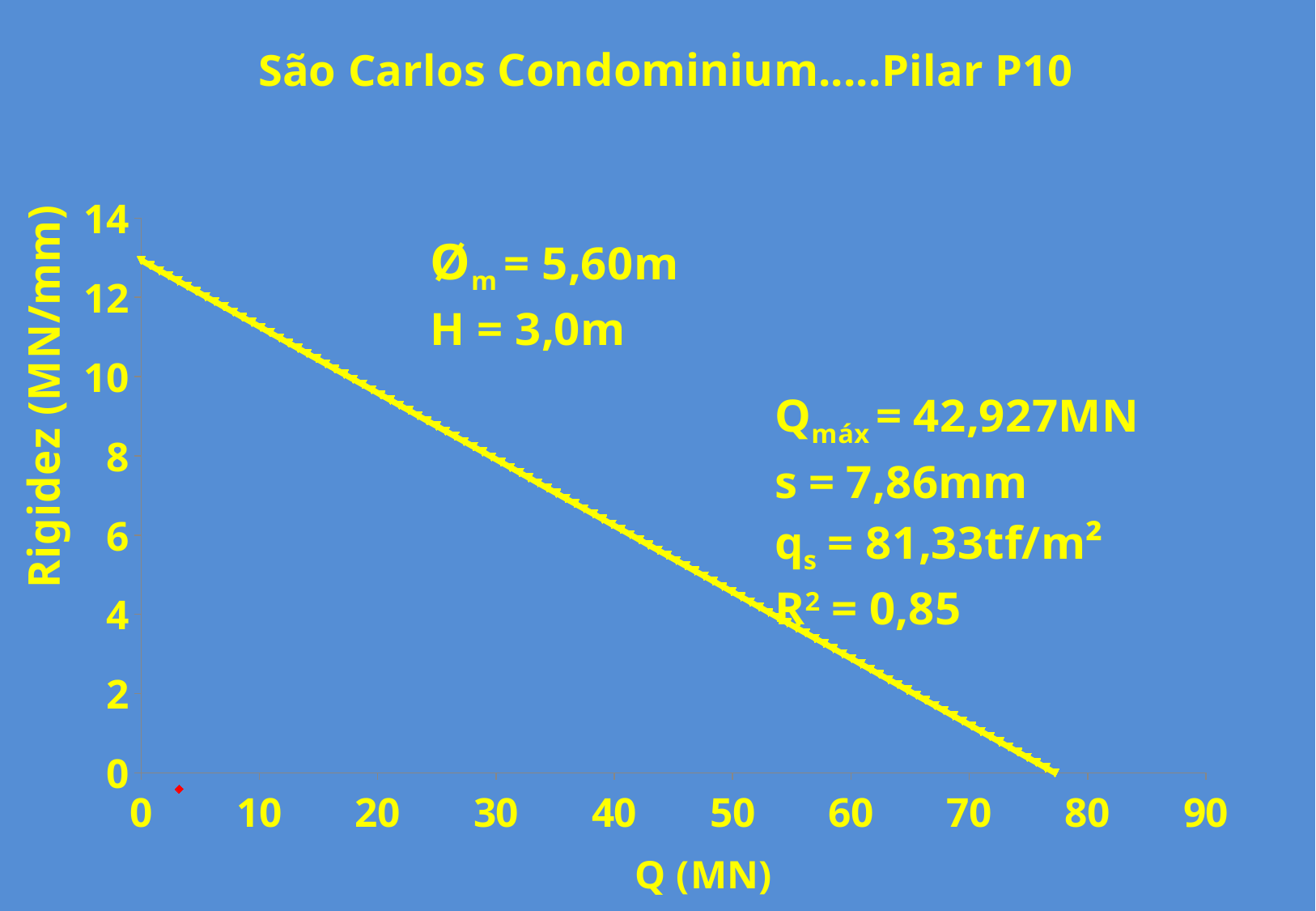
Is the Rigidez value at Q = 60 MN greater or less than 4 MN/mm? less Is the Rigidez value at Q = 50 MN greater or less than 6 MN/mm? less What R² value is printed on the chart? 0,85 Which has the larger Rigidez value, Q = 10 MN or Q = 50 MN? Q = 10 MN Is the Rigidez value at Q = 70 MN greater or less than 2 MN/mm? less What kind of chart is shown on the slide? line chart What is the title of the chart? São Carlos Condominium.....Pilar P10 Does the Rigidez value rise or fall as Q (MN) increases along the x axis? fall